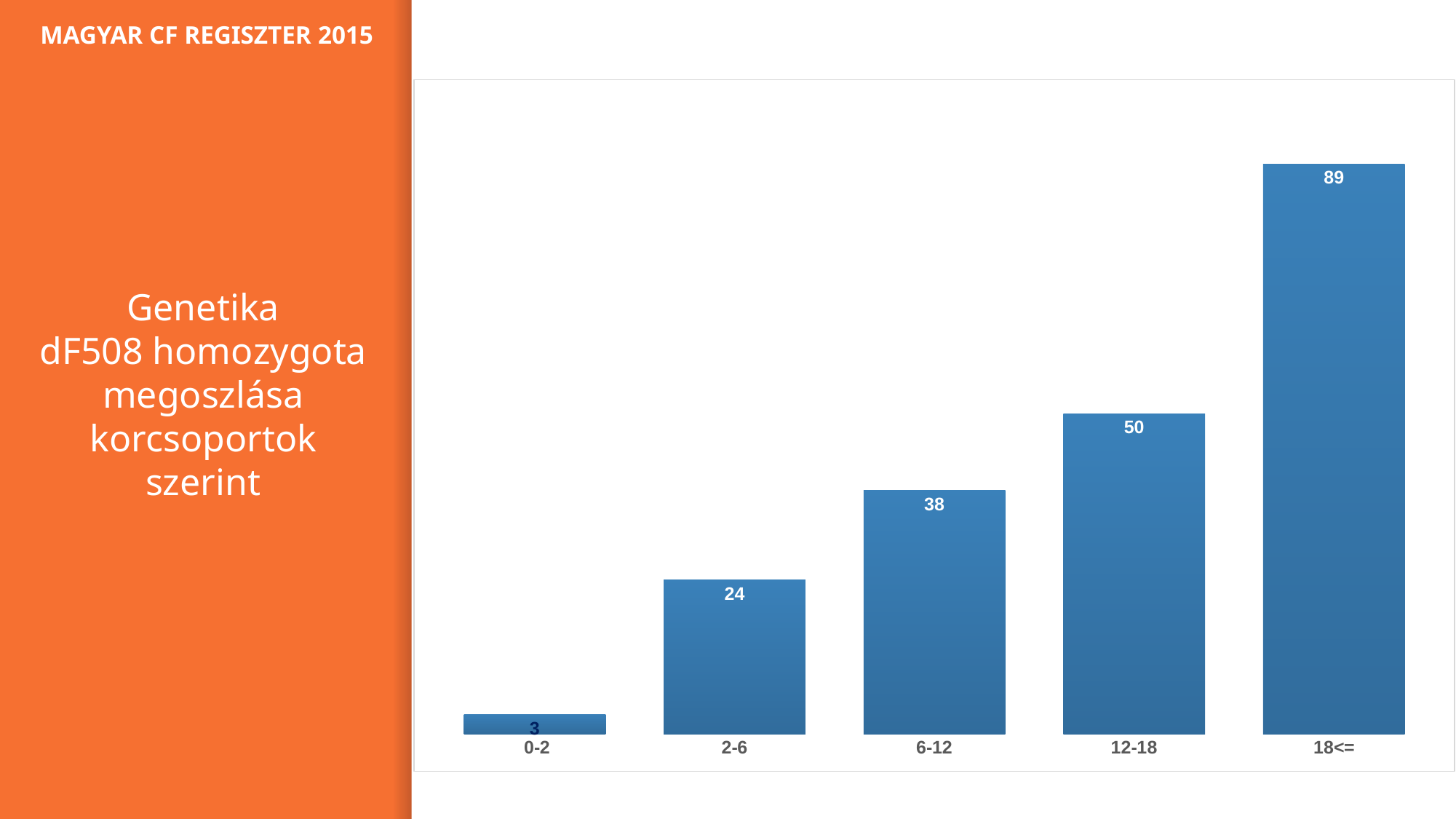
What kind of chart is shown on the slide? Bar chart How many age groups are shown on the chart? 5 Which is larger, the value for 6-12 or the value for 2-6? 6-12 What is the value for the 18<= age group? 89 What is the value for the 6-12 age group? 38 Do the values rise or fall from the 0-2 age group to the 18<= age group? Rise Which age group has the lowest value? 0-2 Which age group has the highest value? 18<= What is the value for the 0-2 age group? 3 What is the difference between the values for the 18<= and 12-18 age groups? 39 What is the value for the 2-6 age group? 24 What is the value for the 12-18 age group? 50